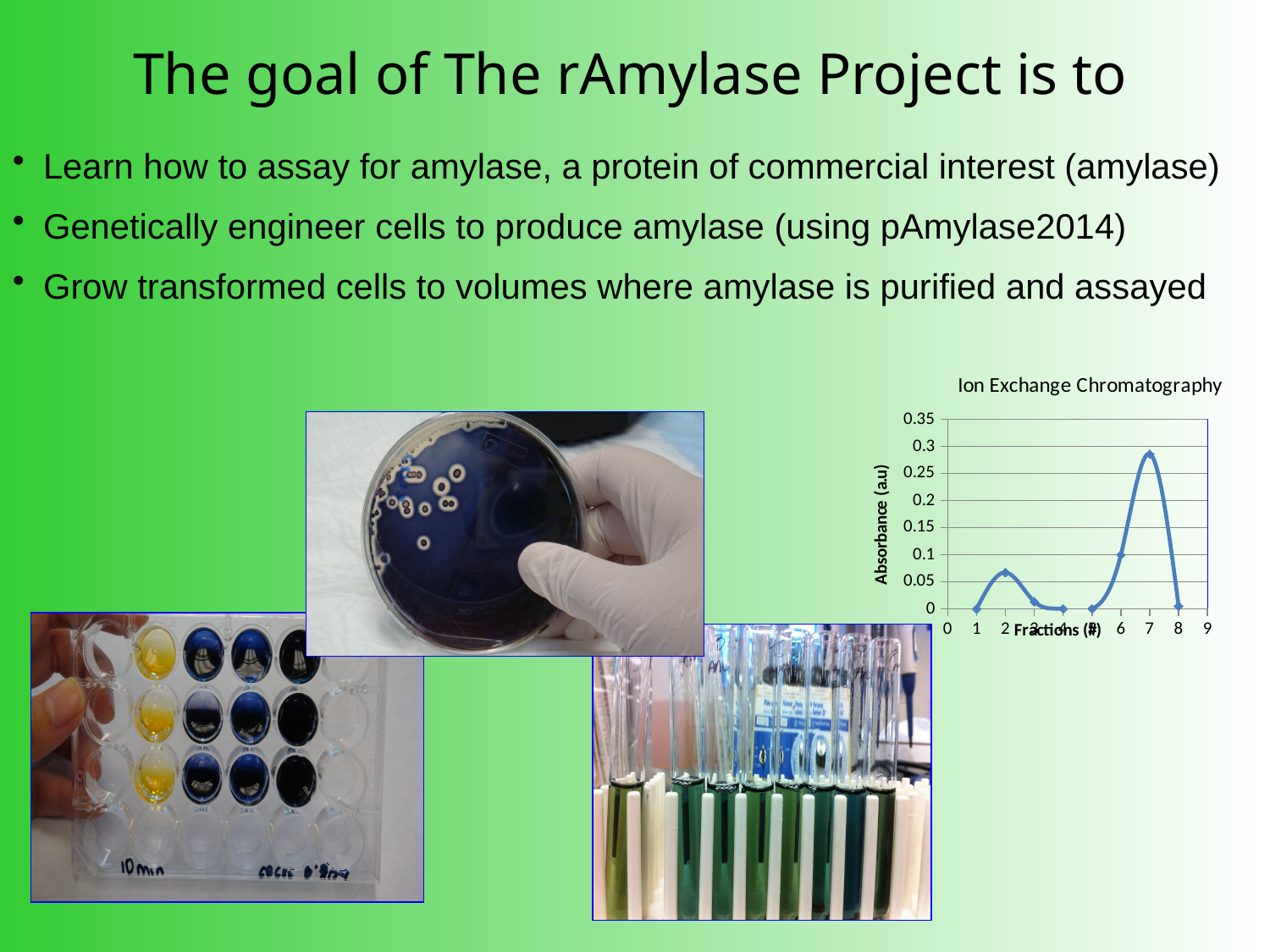
In the Ion Exchange Chromatography chart, is the absorbance for fraction 7 greater or less than 0.25? greater In the Ion Exchange Chromatography chart, which has the higher absorbance, fraction 2 or fraction 7? fraction 7 What is the title of the chart on the slide? Ion Exchange Chromatography What kind of chart is the Ion Exchange Chromatography chart? line chart In the Ion Exchange Chromatography chart, is the absorbance for fraction 2 greater or less than 0.1? less What is the label of the y axis in the Ion Exchange Chromatography chart? Absorbance (a.u) In the Ion Exchange Chromatography chart, is the absorbance for fraction 6 greater or less than 0.05? greater How many data points are plotted in the Ion Exchange Chromatography chart? 8 In the Ion Exchange Chromatography chart, which fraction has the highest absorbance? 7 In the Ion Exchange Chromatography chart, which has the higher absorbance, fraction 6 or fraction 7? fraction 7